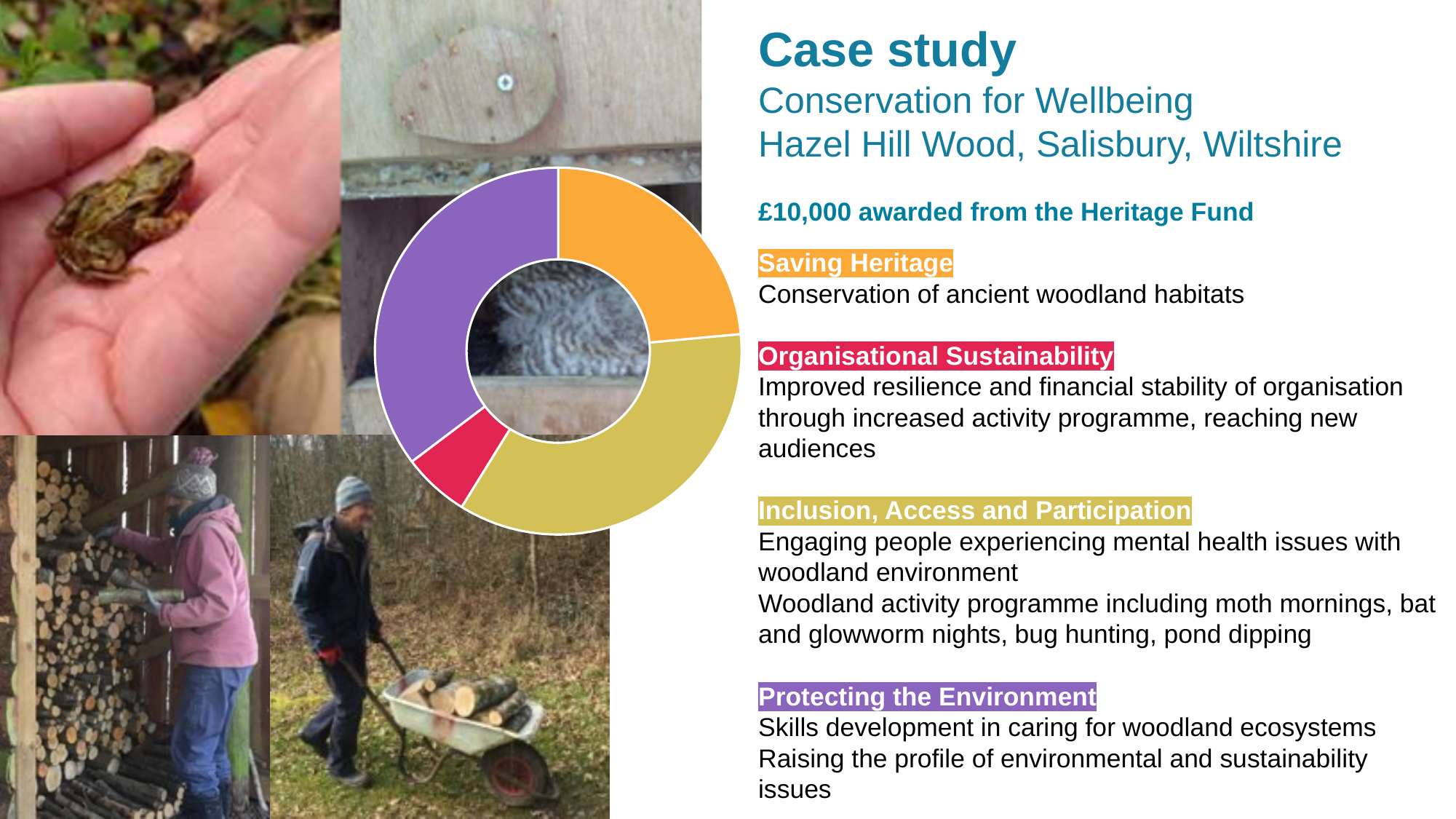
Which outcome is represented by the purple segment of the doughnut chart? Protecting the Environment How many segments does the doughnut chart have? 4 Which segment is larger in the doughnut chart: Saving Heritage or Organisational Sustainability? Saving Heritage Which outcome has the smallest segment in the doughnut chart? Organisational Sustainability Which segment is larger in the doughnut chart: Inclusion, Access and Participation or Organisational Sustainability? Inclusion, Access and Participation Which segment is larger in the doughnut chart: Protecting the Environment or Organisational Sustainability? Protecting the Environment Which colour represents Saving Heritage in the doughnut chart? orange What kind of chart is shown on the slide? doughnut chart